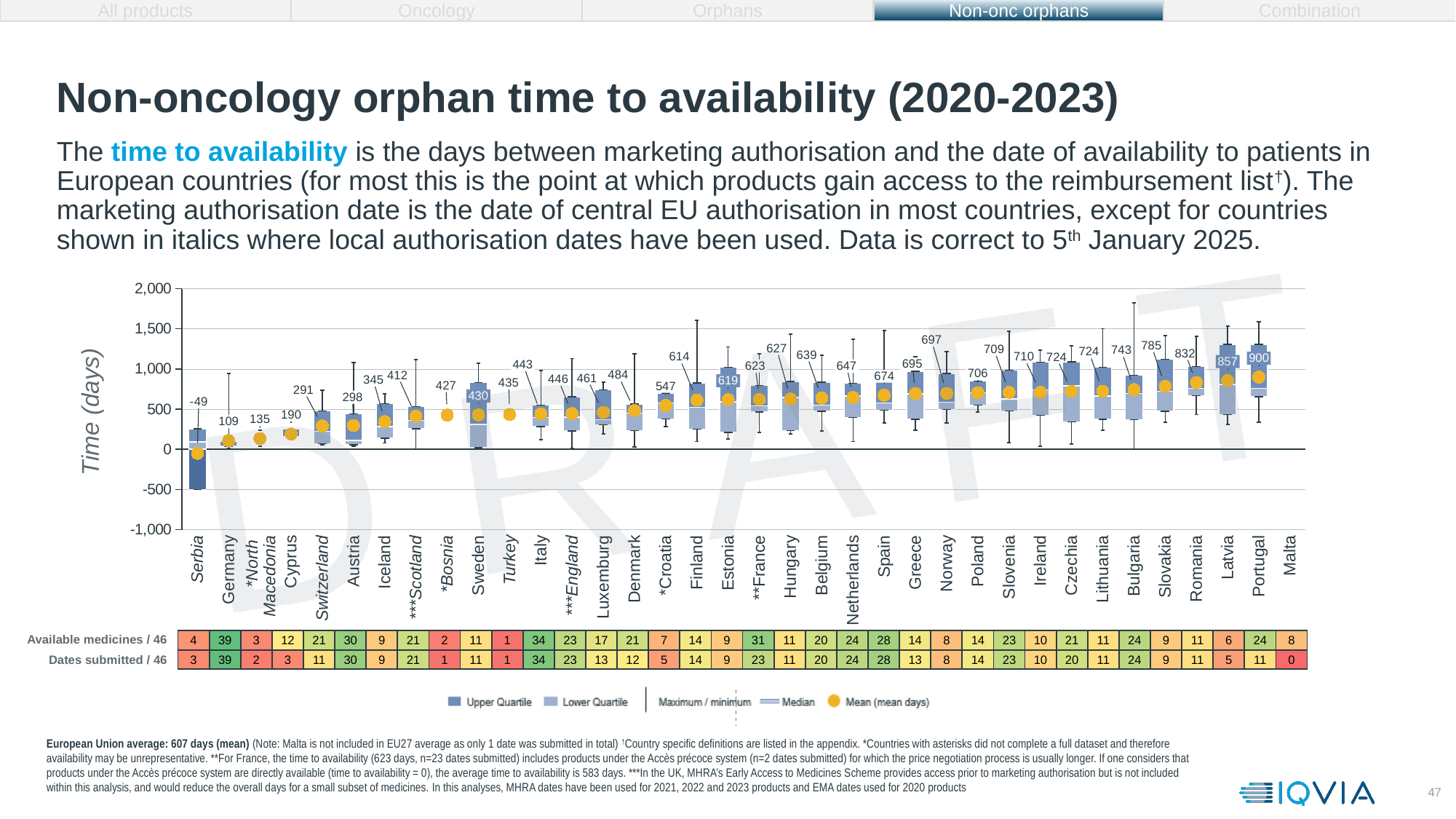
How many entries does the chart legend list? 5 What is the mean time to availability (days) shown for Portugal? 900 What kind of chart is used to show time to availability by country? Box plot Do the labelled mean values generally rise or fall from left to right along the x axis? Rise According to the table below the chart, how many available medicines (out of 46) are shown for Germany? 39 How many countries are shown along the x axis of the chart? 36 What is the mean time to availability (days) shown for France? 623 What is the difference between the labelled mean values for Latvia and Romania? 25 Which has a larger labelled mean time to availability, Sweden or Croatia? Croatia Which country has the highest labelled mean time to availability? Portugal What is the mean time to availability (days) shown for Germany? 109 Which country has the lowest labelled mean time to availability? Serbia